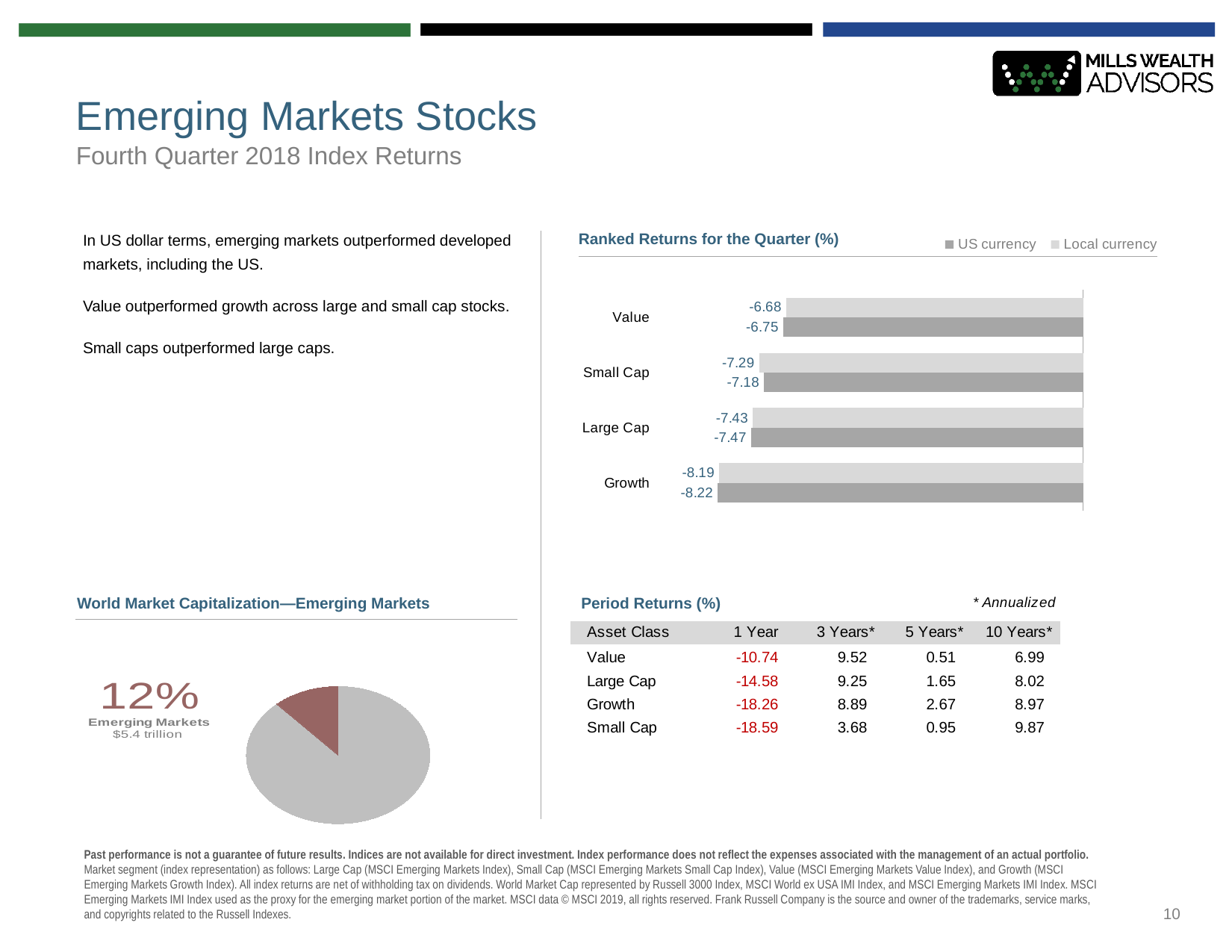
In the Ranked Returns for the Quarter chart, what is the US currency return for Small Cap? -7.18 In the World Market Capitalization—Emerging Markets pie chart, what share does Emerging Markets represent? 12% In the Ranked Returns for the Quarter chart, what is the Local currency return for Growth? -8.19 In the Ranked Returns for the Quarter chart, which category has the highest US currency return? Value How many categories are shown in the Ranked Returns for the Quarter chart? 4 How many series does the legend of the Ranked Returns for the Quarter chart list? 2 In the Ranked Returns for the Quarter chart, which category has the lowest Local currency return? Growth What kind of chart is the Ranked Returns for the Quarter chart? Bar chart In the Ranked Returns for the Quarter chart, what is the US currency return for Value? -6.75 In the Ranked Returns for the Quarter chart, what is the difference between the US currency returns for Value and Growth? 1.47 In the Ranked Returns for the Quarter chart, what is the Local currency return for Large Cap? -7.43 In the Ranked Returns for the Quarter chart, which is larger, the US currency return for Small Cap or for Large Cap? Small Cap